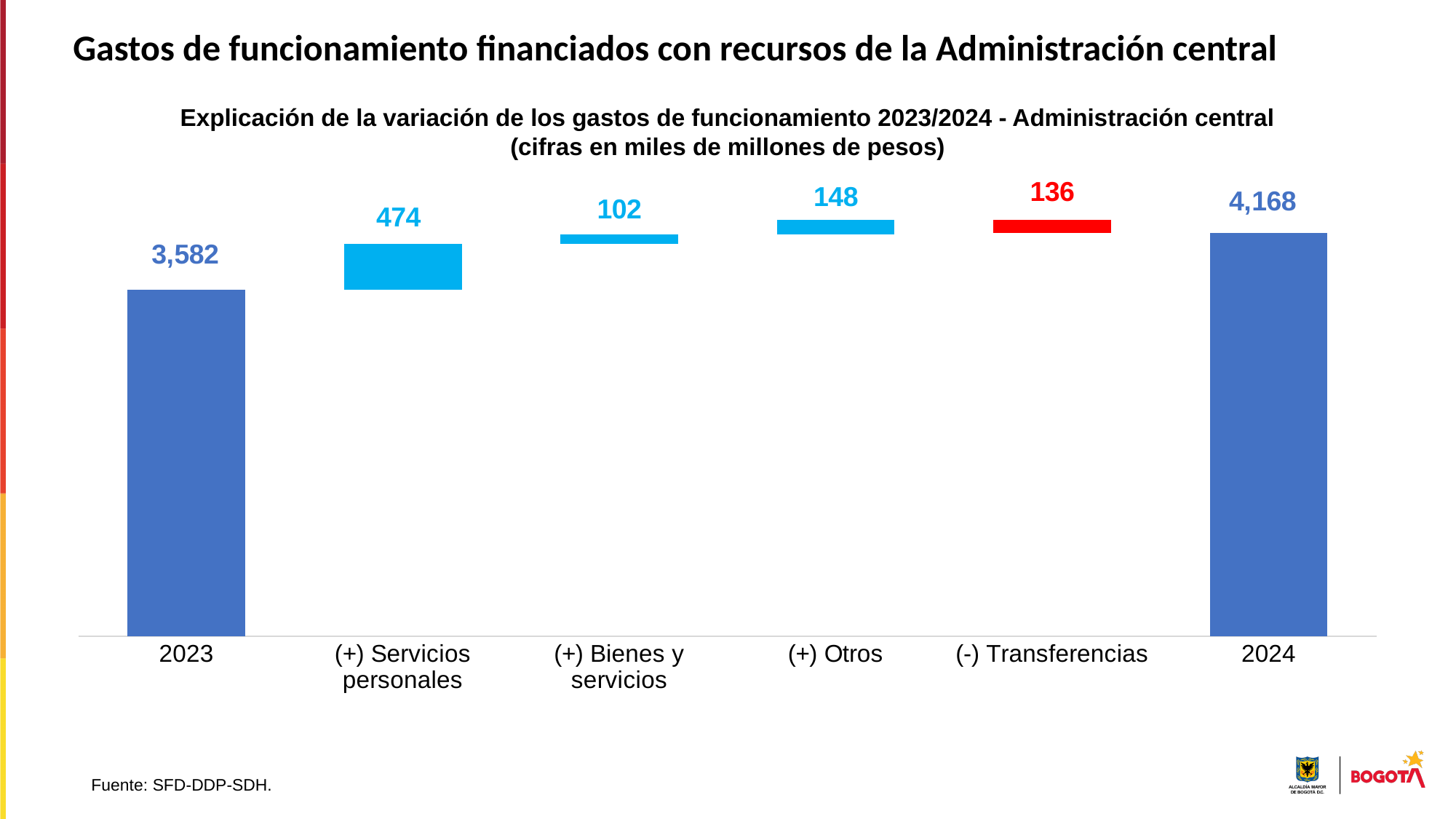
Which is larger, the value for (+) Otros or the value for (-) Transferencias? (+) Otros Which category has the lowest value on the chart? (+) Bienes y servicios What is the value shown for 2023? 3,582 What is the difference between the 2024 value and the 2023 value? 586 What kind of chart is this? Bar chart What is the value shown for (-) Transferencias? 136 What colour is the bar for (-) Transferencias? Red What is the value shown for 2024? 4,168 What is the value shown for (+) Servicios personales? 474 How many categories are shown on the x axis? 6 What is the value shown for (+) Bienes y servicios? 102 Which category has the highest value on the chart? 2024